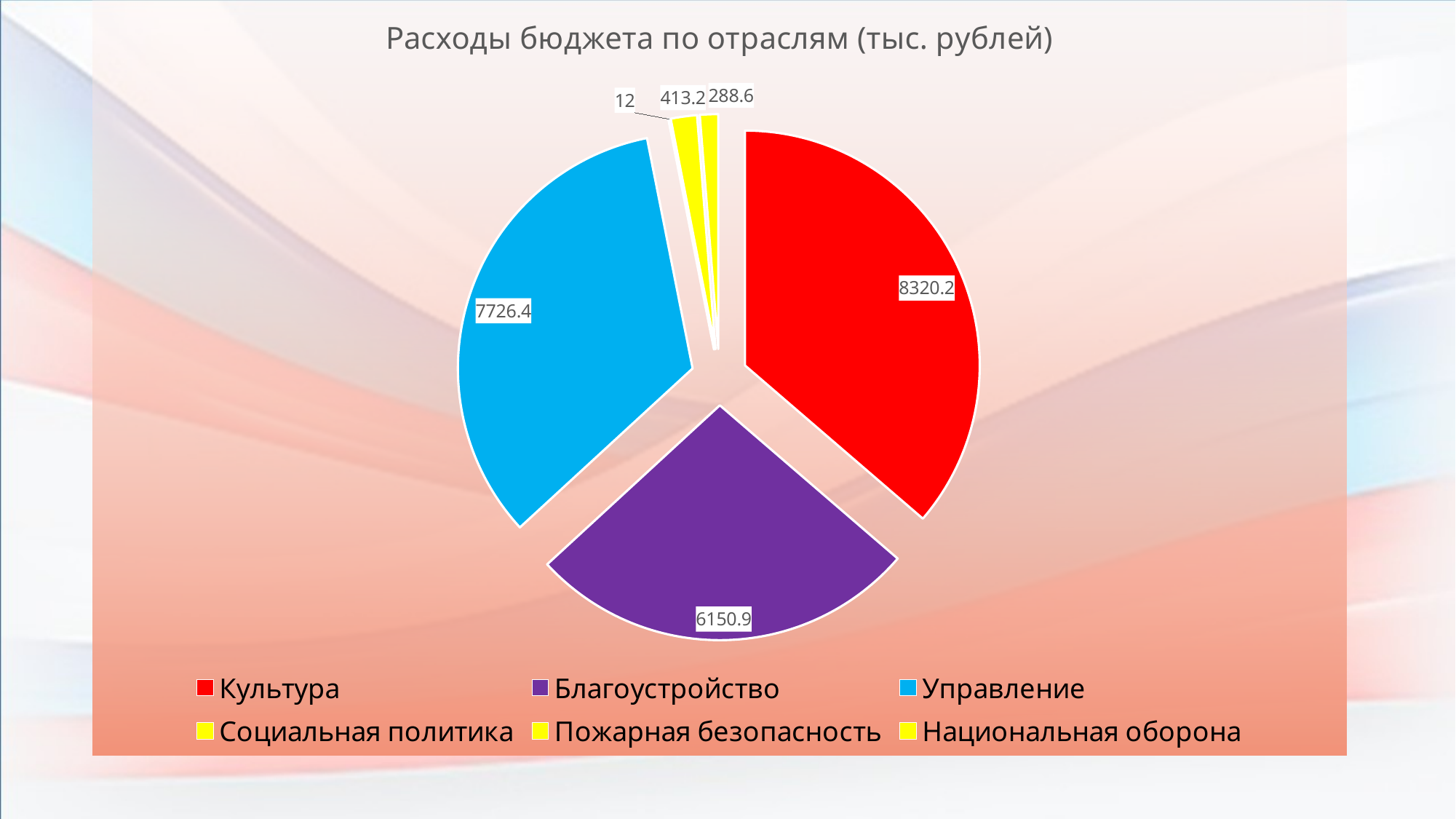
What type of chart is shown on the slide? pie chart What is the difference between the values for Культура and Управление? 593.8 What is the value for Культура? 8320.2 How many entries does the legend list? 6 What is the difference between the values for Управление and Благоустройство? 1575.5 Which is larger, the value for Благоустройство or the value for Управление? Управление How many slices does the pie chart have? 6 What is the value for Благоустройство? 6150.9 What is the value for Управление? 7726.4 What is the smallest value labelled on the pie? 12 What is the title of the chart? Расходы бюджета по отраслям (тыс. рублей) Which category has the largest slice of the pie? Культура